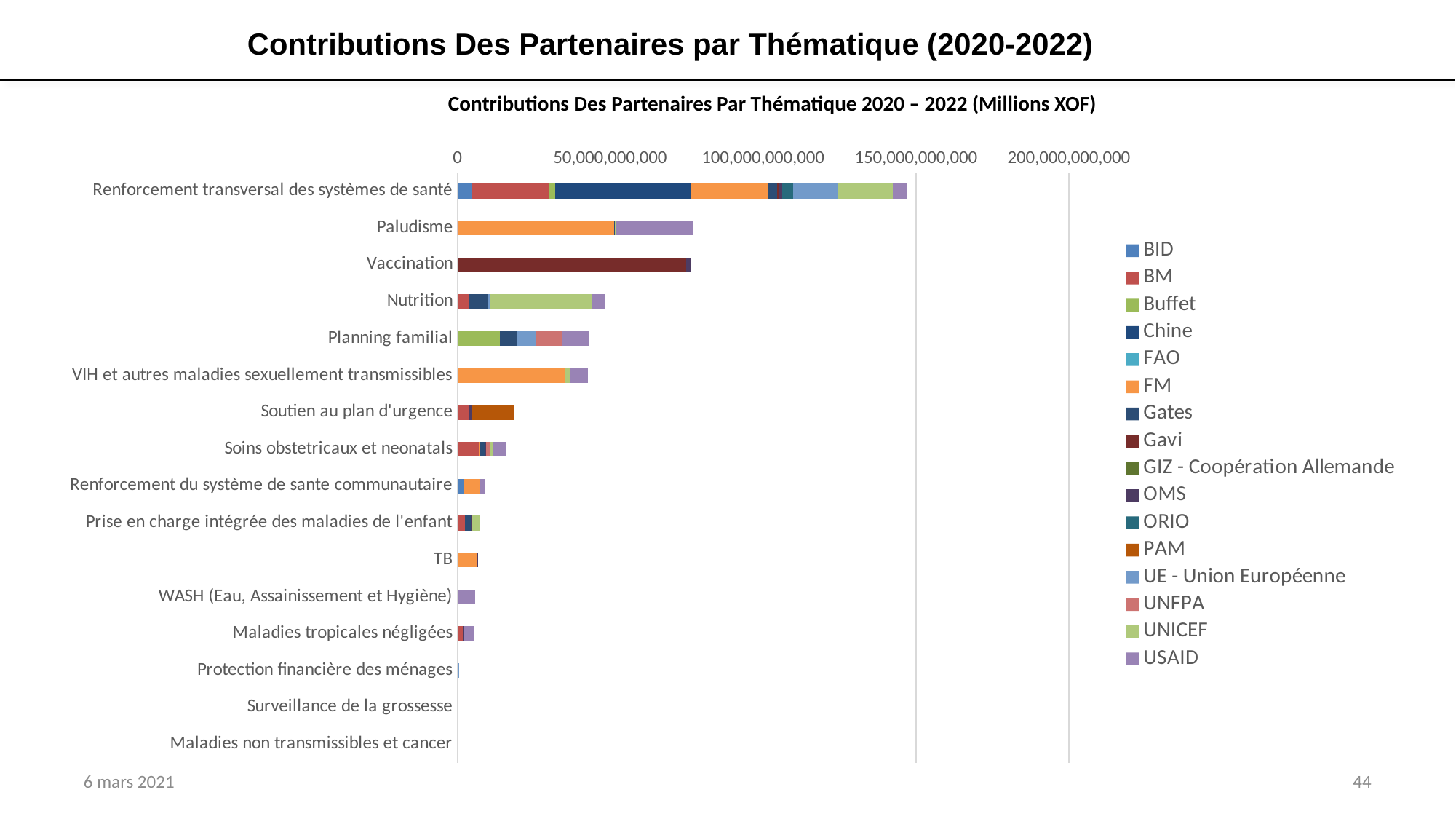
Is the total contribution for Renforcement transversal des systèmes de santé greater or less than 100,000,000,000? greater What is the title of the chart? Contributions Des Partenaires Par Thématique 2020 – 2022 (Millions XOF) Which has a larger total contribution, Paludisme or Nutrition? Paludisme Which has a larger total contribution, Vaccination or Planning familial? Vaccination How many thematic categories are listed on the vertical axis of the chart? 16 What kind of chart is shown on the slide? Stacked horizontal bar chart Is the total contribution for TB greater or less than 50,000,000,000? less How many partner series does the legend list? 16 Is the total contribution for Paludisme greater or less than 100,000,000,000? less Which thematic category has the largest total contribution? Renforcement transversal des systèmes de santé